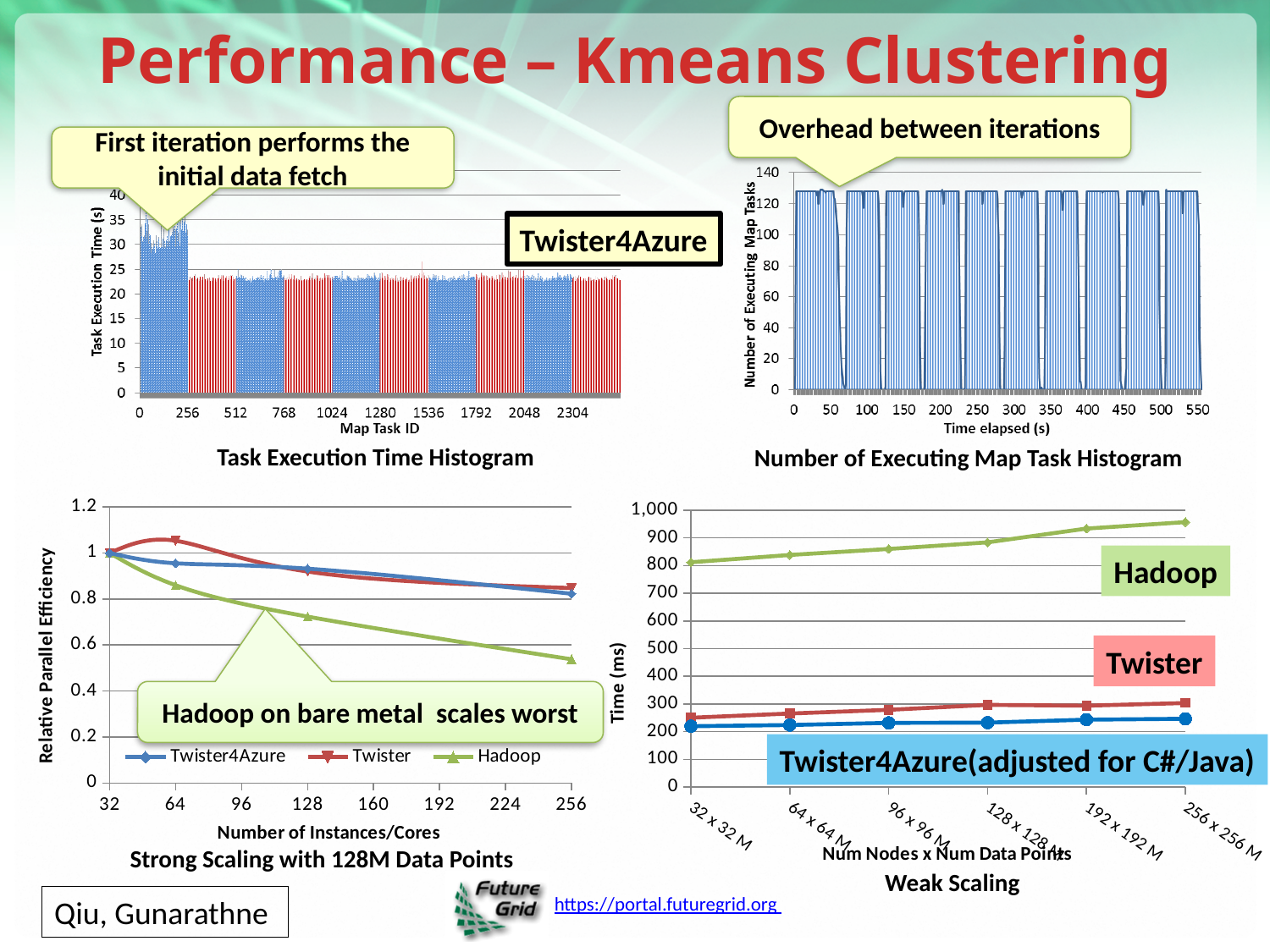
What kind of chart is the Task Execution Time Histogram (top-left)? bar chart How many categories are shown on the x axis of the Weak Scaling chart (bottom-right)? 6 In the Weak Scaling chart, is the Hadoop value at 256 x 256 M greater or less than 900? greater In the Strong Scaling with 128M Data Points chart, which series has the lowest relative parallel efficiency at 256 instances/cores? Hadoop In the Strong Scaling with 128M Data Points chart, which series has the highest relative parallel efficiency at 64 instances/cores? Twister In the Number of Executing Map Task Histogram (top-right), is the peak number of executing map tasks greater or less than 140? less In the Weak Scaling chart, does the Hadoop series rise or fall from 32 x 32 M to 256 x 256 M? rise How many series does the legend of the Strong Scaling with 128M Data Points chart list? 3 What kind of chart is the Strong Scaling with 128M Data Points chart (bottom-left)? line chart In the Strong Scaling with 128M Data Points chart, is the Hadoop value at 256 instances/cores greater or less than 0.6? less In the Strong Scaling with 128M Data Points chart, does the Hadoop series rise or fall as the number of instances/cores increases? fall In the Weak Scaling chart, which series has the highest time at 256 x 256 M? Hadoop